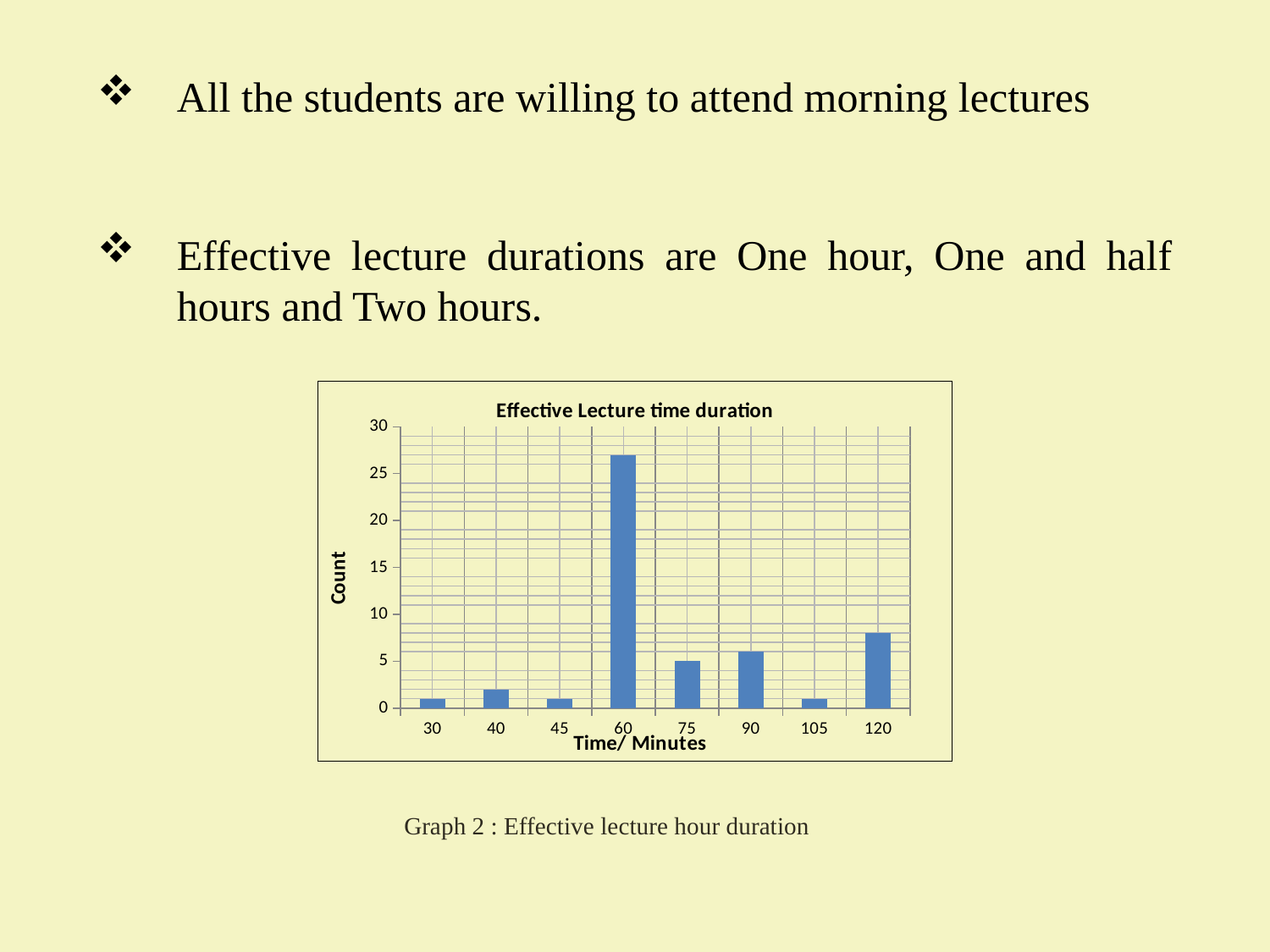
Is the count for the 60 minute duration greater or less than 25? greater What is the label of the x axis of the chart? Time/ Minutes Which has a higher count, the 60 minute duration or the 120 minute duration? 60 Which time duration has the highest count in the chart? 60 Is the count for the 90 minute duration greater or less than 5? greater What is the title of the chart? Effective Lecture time duration How many time categories are shown on the x axis of the chart? 8 Is the count for the 40 minute duration greater or less than 5? less Which has a higher count, the 120 minute duration or the 90 minute duration? 120 What is the count for the 75 minute duration? 5 What type of chart is shown on the slide? bar chart